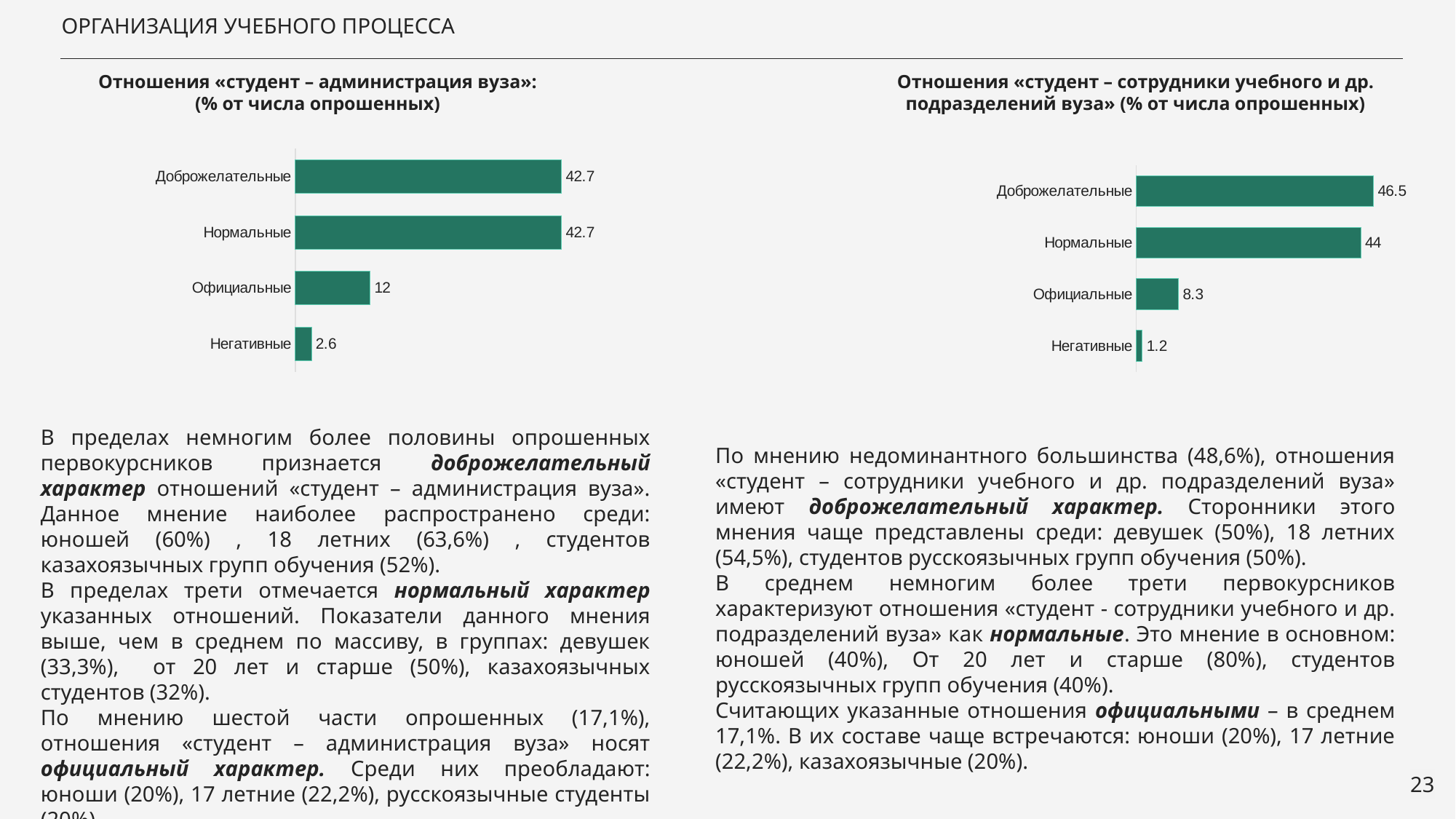
In the left chart «Отношения «студент – администрация вуза»», what is the difference between Доброжелательные and Официальные? 30.7 In the right chart «Отношения «студент – сотрудники учебного и др. подразделений вуза»», which category has the highest value? Доброжелательные In the right chart «Отношения «студент – сотрудники учебного и др. подразделений вуза»», what is the value for Официальные? 8.3 In the right chart «Отношения «студент – сотрудники учебного и др. подразделений вуза»», what is the difference between Нормальные and Официальные? 35.7 In the left chart «Отношения «студент – администрация вуза»», how many categories are shown? 4 In the left chart «Отношения «студент – администрация вуза»», what is the value for Официальные? 12 In the left chart «Отношения «студент – администрация вуза»», which category has the lowest value? Негативные In the left chart «Отношения «студент – администрация вуза»», what is the value for Негативные? 2.6 What type of chart is the right chart «Отношения «студент – сотрудники учебного и др. подразделений вуза»»? Bar chart In the right chart «Отношения «студент – сотрудники учебного и др. подразделений вуза»», what is the value for Доброжелательные? 46.5 Which is larger: Официальные in the left chart or Официальные in the right chart? Официальные in the left chart In the right chart «Отношения «студент – сотрудники учебного и др. подразделений вуза»», which category has the lowest value? Негативные